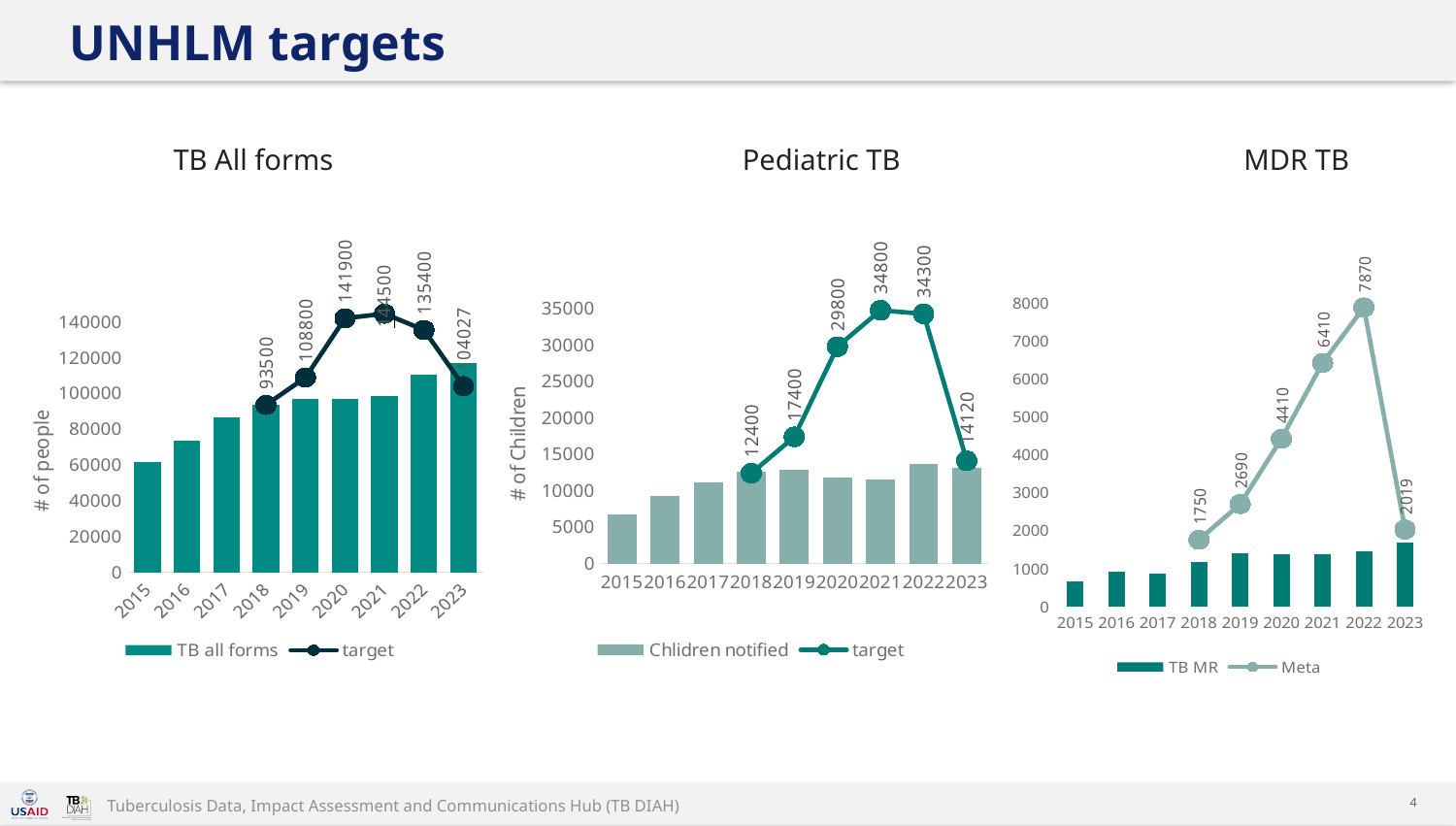
In the Pediatric TB chart, which year has the lowest target value? 2018 In the Pediatric TB chart, which is larger: the target for 2020 or the target for 2023? 2020 How many years are shown on the x axis of the MDR TB chart? 9 In the TB All forms chart, what is the target value for 2019? 108800 In the MDR TB chart, what is the difference between the Meta values for 2022 and 2018? 6120 In the MDR TB chart, does the Meta line rise or fall from 2018 to 2022? rise In the MDR TB chart, what is the Meta value for 2020? 4410 In the TB All forms chart, is the TB all forms bar for 2022 greater or less than 100000? greater In the Pediatric TB chart, what is the target value for 2021? 34800 In the Pediatric TB chart, is the Children notified bar for 2015 greater or less than 10000? less In the Pediatric TB chart, what is the difference between the target values for 2021 and 2018? 22400 In the MDR TB chart, which year has the highest Meta value? 2022